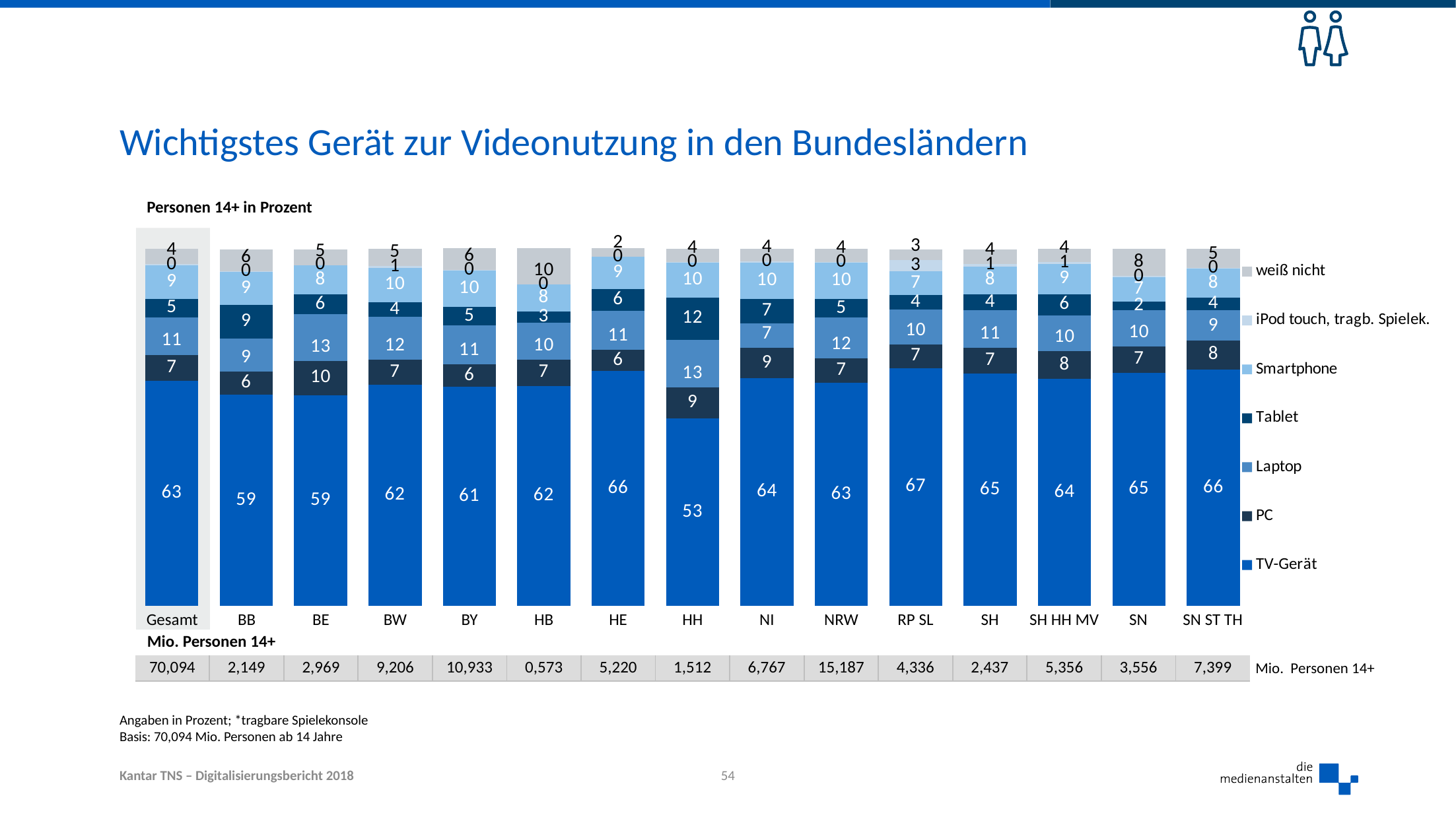
What is the Mio. Personen 14+ figure shown for NRW? 15,187 What kind of chart is shown on the slide? Stacked bar chart How many series does the legend list? 7 What is the difference between the TV-Gerät values for RP SL and HH? 14 Which is larger, the PC value for BE or the PC value for BB? BE What is the TV-Gerät value for HH? 53 How many categories (bars) are shown on the x axis? 15 Which category has the highest TV-Gerät value? RP SL What is the Laptop value for BE? 13 Which category has the highest Tablet value? HH Which category has the lowest TV-Gerät value? HH Which category has the highest 'weiß nicht' value? HB